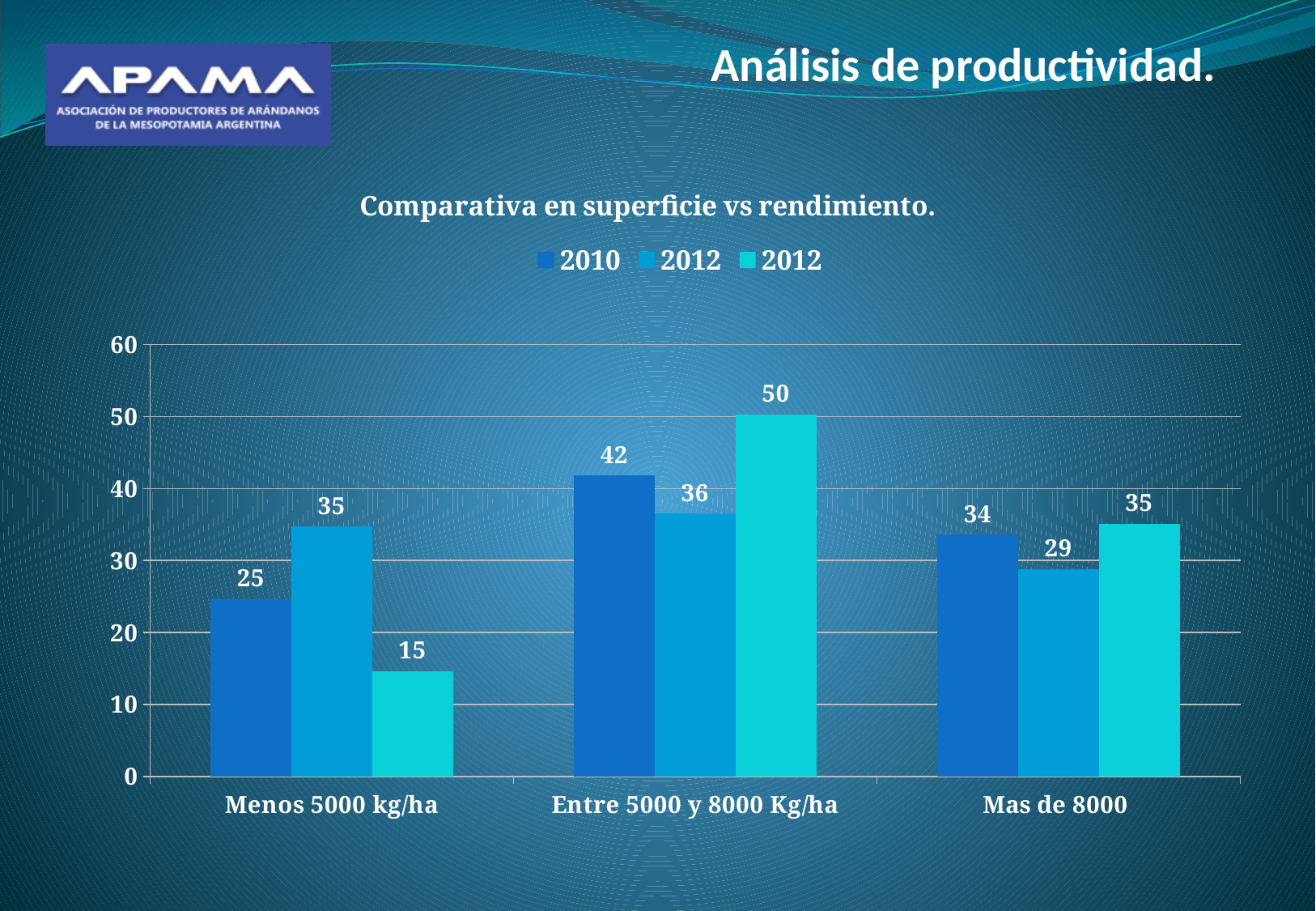
Which category has the highest value for the 2010 series? Entre 5000 y 8000 Kg/ha What is the value of the tallest bar in the 'Entre 5000 y 8000 Kg/ha' group? 50 What is the lowest value shown on the chart? 15 What is the value of the 2010 series for the category 'Mas de 8000'? 34 What is the value of the 2010 series for the category 'Entre 5000 y 8000 Kg/ha'? 42 What is the difference between the 2010 values for 'Entre 5000 y 8000 Kg/ha' and 'Menos 5000 kg/ha'? 17 What is the title of the chart? Comparativa en superficie vs rendimiento. What kind of chart is shown on the slide? Bar chart How many series does the legend list? 3 How many categories are shown on the x axis? 3 For the 2010 series, which category has the larger value: 'Mas de 8000' or 'Menos 5000 kg/ha'? Mas de 8000 What is the value of the 2010 series for the category 'Menos 5000 kg/ha'? 25